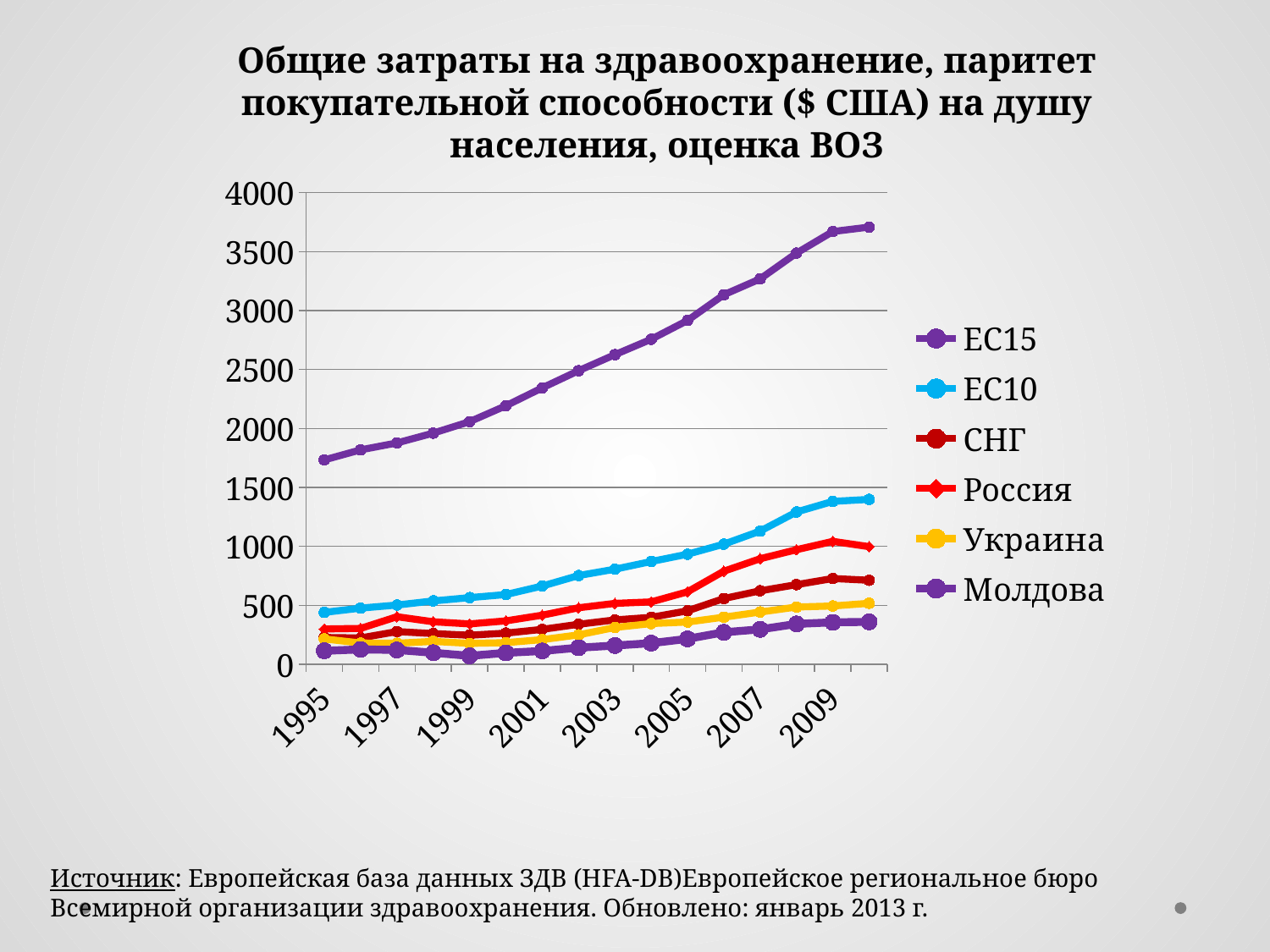
In 2009, which is larger: the value for ЕС15 or the value for ЕС10? ЕС15 Is the value for ЕС15 in 1995 greater or less than 1500? greater Is the value for Молдова in 2009 greater or less than 500? less Which series has the lowest values throughout the chart? Молдова Is the value for ЕС15 in 2009 greater or less than 3500? greater Which series has the highest values throughout the chart? ЕС15 How many series does the legend list? 6 What kind of chart is shown on the slide? line chart Which series is drawn in light blue? ЕС10 Does the ЕС15 series rise or fall from 1995 to 2009? rise In 2009, which is larger: the value for Россия or the value for Украина? Россия